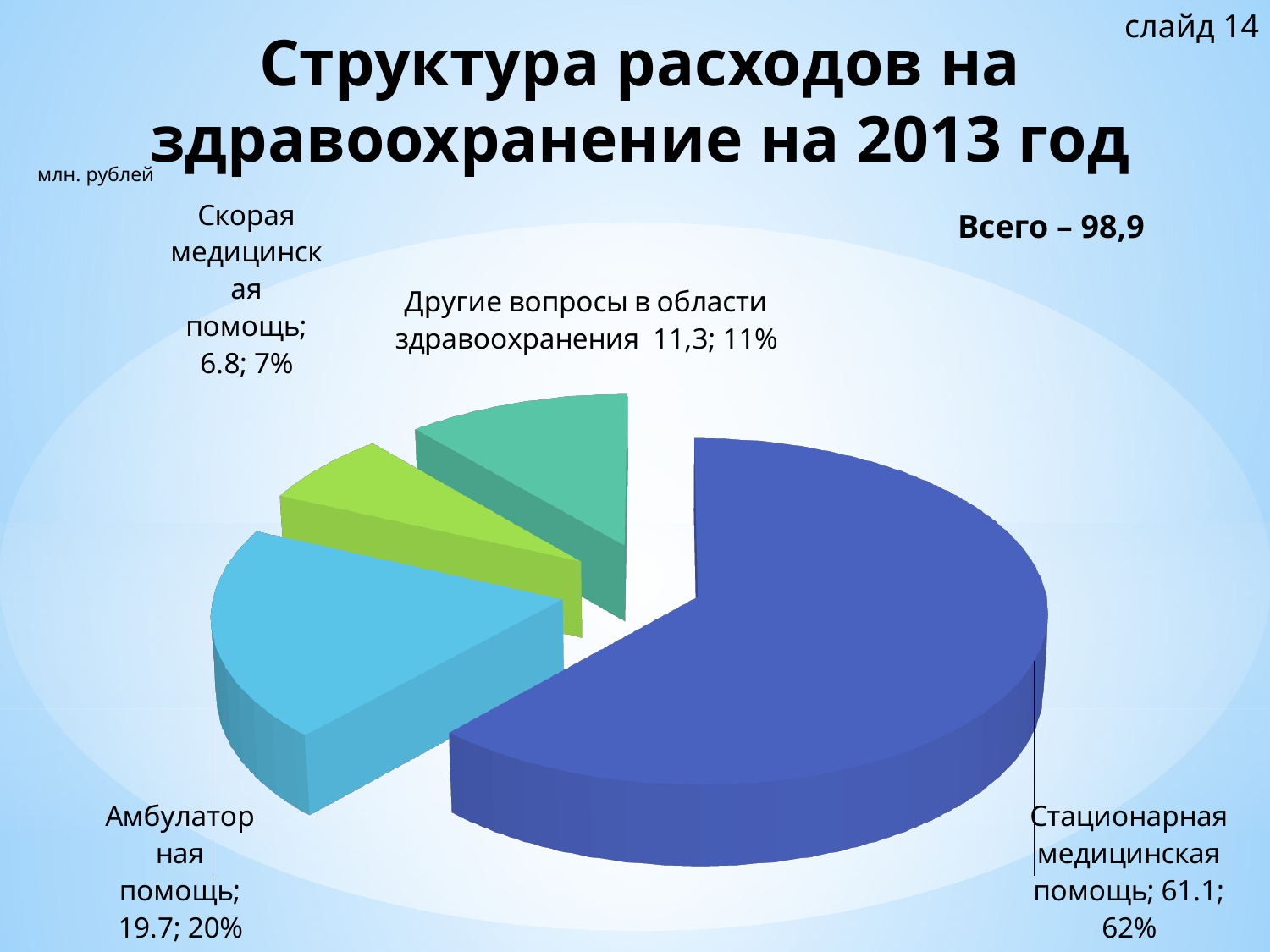
What share of the pie does Стационарная медицинская помощь represent? 62% What is the value for Скорая медицинская помощь? 6.8 What total is stated on the slide for all expenditures (Всего)? 98,9 What share of the pie does Амбулаторная помощь represent? 20% Which category has the smallest slice of the pie? Скорая медицинская помощь What is the value for Амбулаторная помощь? 19.7 What is the value for Стационарная медицинская помощь? 61.1 How many slices does the pie chart have? 4 What is the value for Другие вопросы в области здравоохранения? 11,3 Which category has the largest slice of the pie? Стационарная медицинская помощь What kind of chart is shown on the slide? Pie chart Which is larger, the value for Другие вопросы в области здравоохранения or the value for Скорая медицинская помощь? Другие вопросы в области здравоохранения